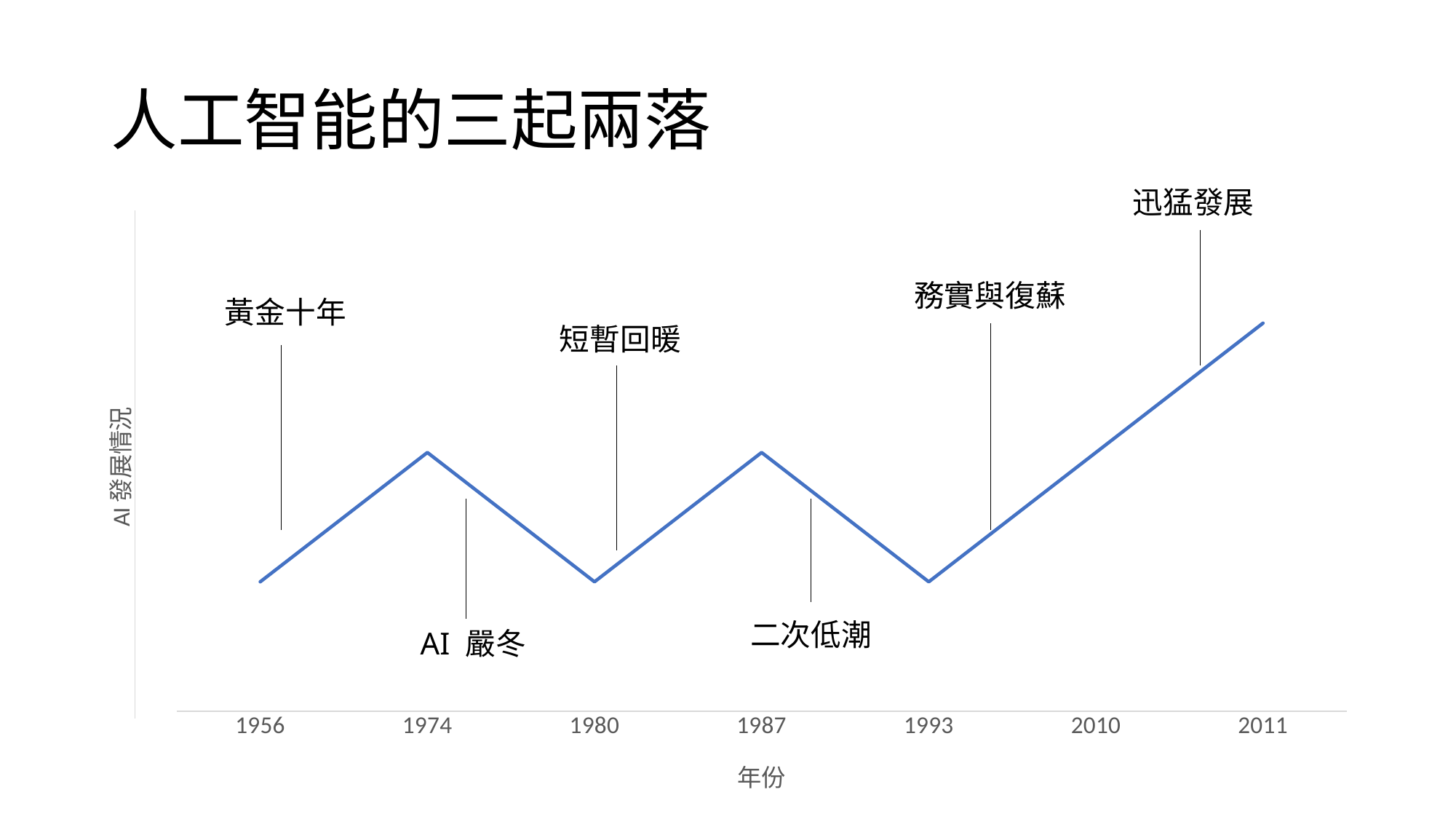
Does the line rise or fall from 1993 to 2011? rise What kind of chart is shown on the slide? line chart Which year on the x axis has the highest point on the line? 2011 What is the label of the x axis of the chart? 年份 Which is higher on the line, the point at 1974 or the point at 1980? 1974 Does the line rise or fall from 1987 to 1993? fall Does the line rise or fall from 1974 to 1980? fall What is the title of the slide containing the chart? 人工智能的三起兩落 Which is higher on the line, the point at 2011 or the point at 1987? 2011 Which is higher on the line, the point at 1987 or the point at 1993? 1987 How many years are marked on the x axis of the chart? 7